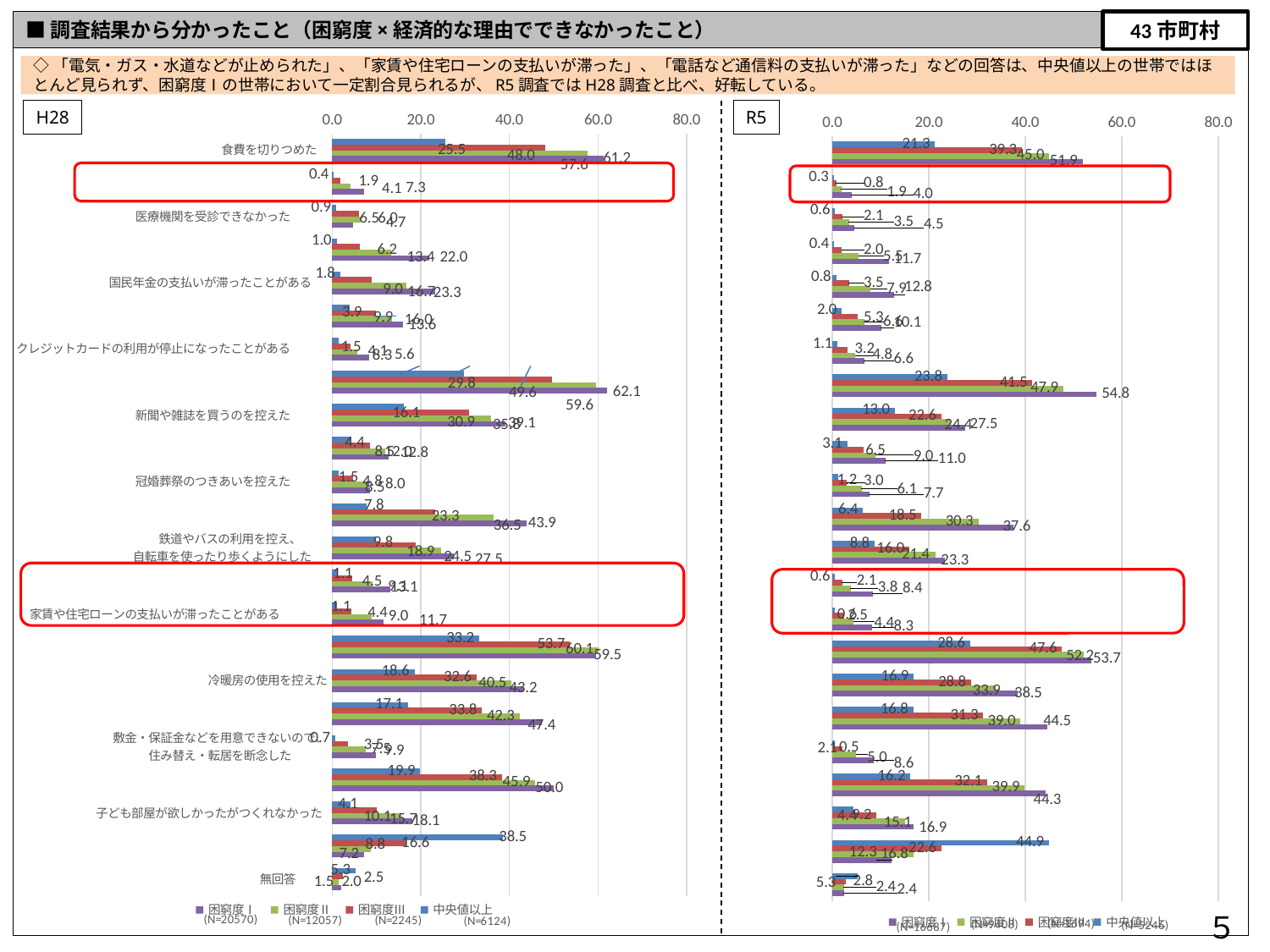
In the H28 chart, which series has the highest value for 食費を切りつめた? 困窮度Ⅰ In the H28 chart, what is the value for 困窮度Ⅰ for 食費を切りつめた? 61.2 In the H28 chart, what is the difference between 困窮度Ⅰ and 中央値以上 for 食費を切りつめた? 35.7 How many series does the legend of the H28 chart list? 4 In the H28 chart legend, what is the N for 困窮度Ⅰ? N=20570 In the H28 chart, which is larger for 冷暖房の使用を控えた: 困窮度Ⅰ or 中央値以上? 困窮度Ⅰ In the H28 chart, what is the value for 中央値以上 for 食費を切りつめた? 25.5 What kind of chart is the H28 chart on the left? bar chart In the R5 chart, what is the value for 困窮度Ⅰ for 食費を切りつめた? 51.9 In the R5 chart, what is the value for 中央値以上 for 冷暖房の使用を控えた? 16.9 In the R5 chart, is the value for 困窮度Ⅰ for 冷暖房の使用を控えた greater or less than 20.0? greater In the R5 chart, what is the value for 中央値以上 for 食費を切りつめた? 21.3